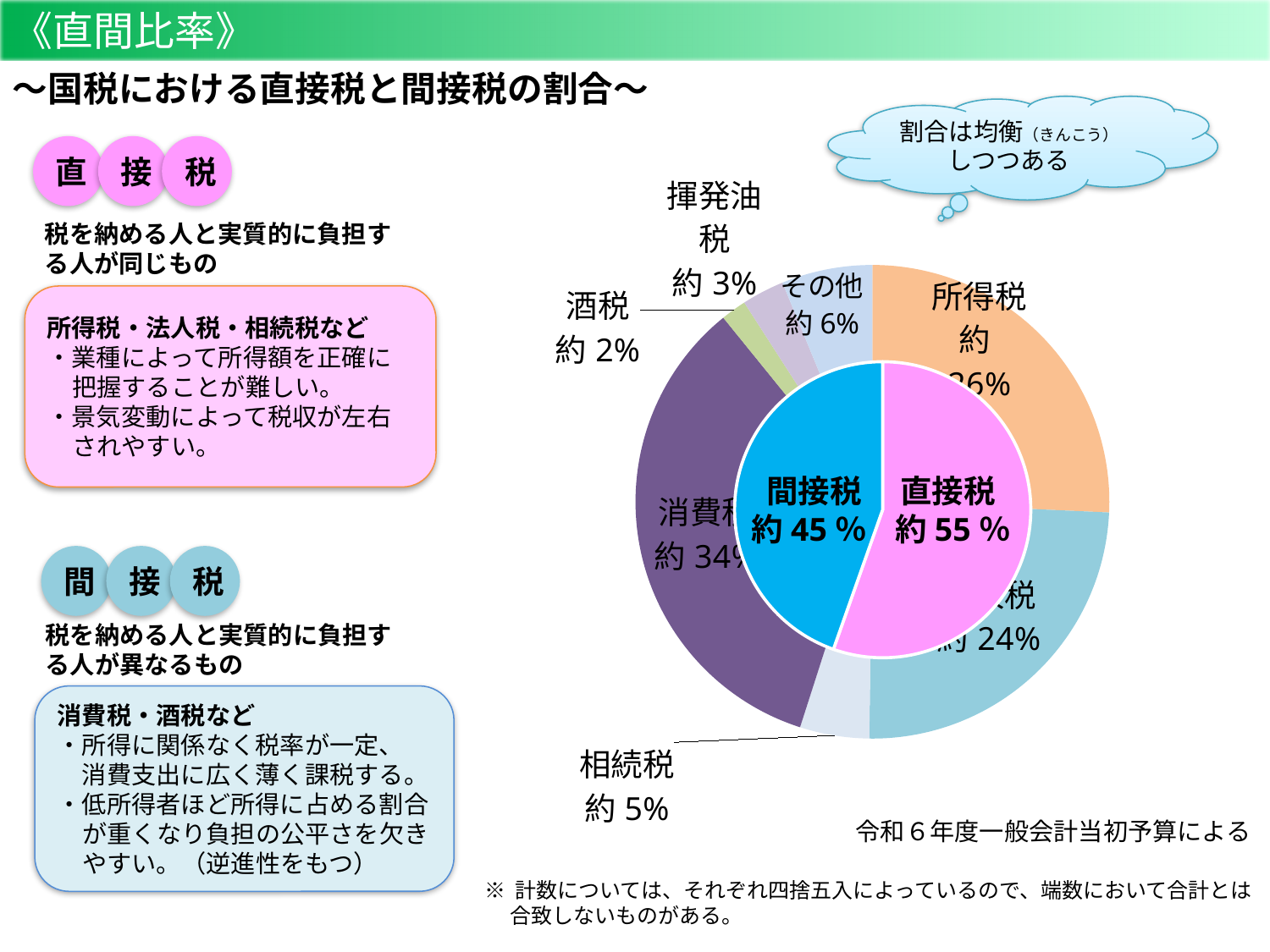
Which slice in the outer ring is the smallest? 酒税 What kind of chart is shown on the slide? Doughnut (pie) chart What share is shown for 酒税 in the outer ring? 約 2% What share does 間接税 have in the inner ring of the chart? 約 45 % What share is shown for 相続税 in the outer ring? 約 5% Which slice in the outer ring is the largest? 消費税 By how many percentage points does 直接税 exceed 間接税 in the inner ring? 10 percentage points Which is larger in the inner ring, 直接税 or 間接税? 直接税 What share does 直接税 have in the inner ring of the chart? 約 55 % According to the note under the chart, which budget is the data based on? 令和６年度一般会計当初予算 What share is shown for 揮発油税 in the outer ring? 約 3% What share is shown for その他 in the outer ring? 約 6%